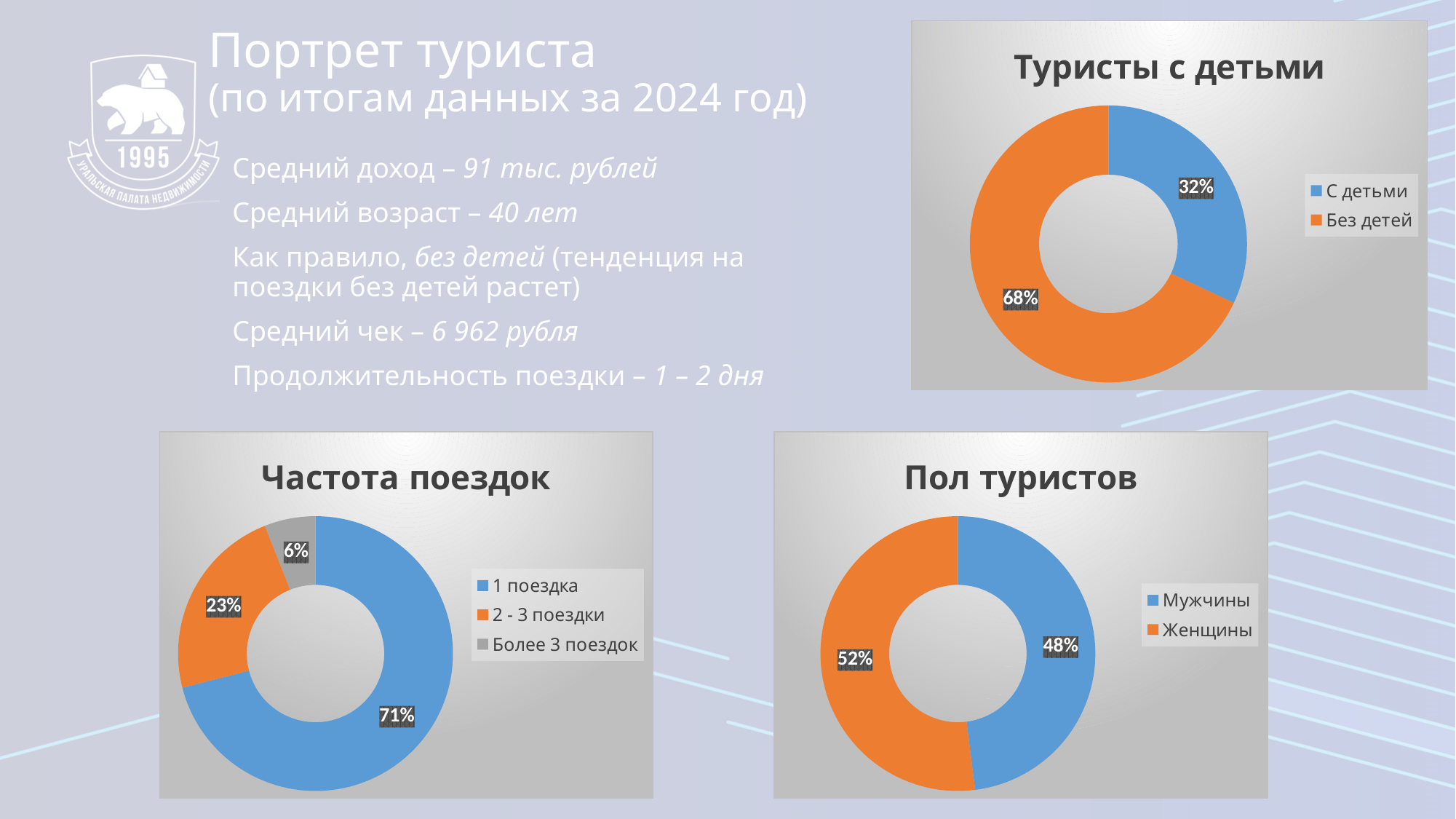
In the 'Туристы с детьми' chart, which category has the larger share? Без детей In the 'Частота поездок' chart, what is the difference between the '1 поездка' and '2 - 3 поездки' shares? 48% In the 'Пол туристов' chart, what share is labelled for 'Женщины'? 52% In the 'Пол туристов' chart, which is larger, 'Мужчины' or 'Женщины'? Женщины What kind of chart is the 'Пол туристов' chart? Doughnut (pie) chart How many categories does the legend of the 'Частота поездок' chart list? 3 In the 'Туристы с детьми' chart, what share is labelled for 'С детьми'? 32% In the 'Частота поездок' chart, what share is labelled for 'Более 3 поездок'? 6% In the 'Частота поездок' chart, what share is labelled for '1 поездка'? 71% In the 'Частота поездок' chart, which category has the smallest share? Более 3 поездок In the 'Туристы с детьми' chart, what is the difference between the 'Без детей' and 'С детьми' shares? 36% In the 'Туристы с детьми' chart, what share is labelled for 'Без детей'? 68%